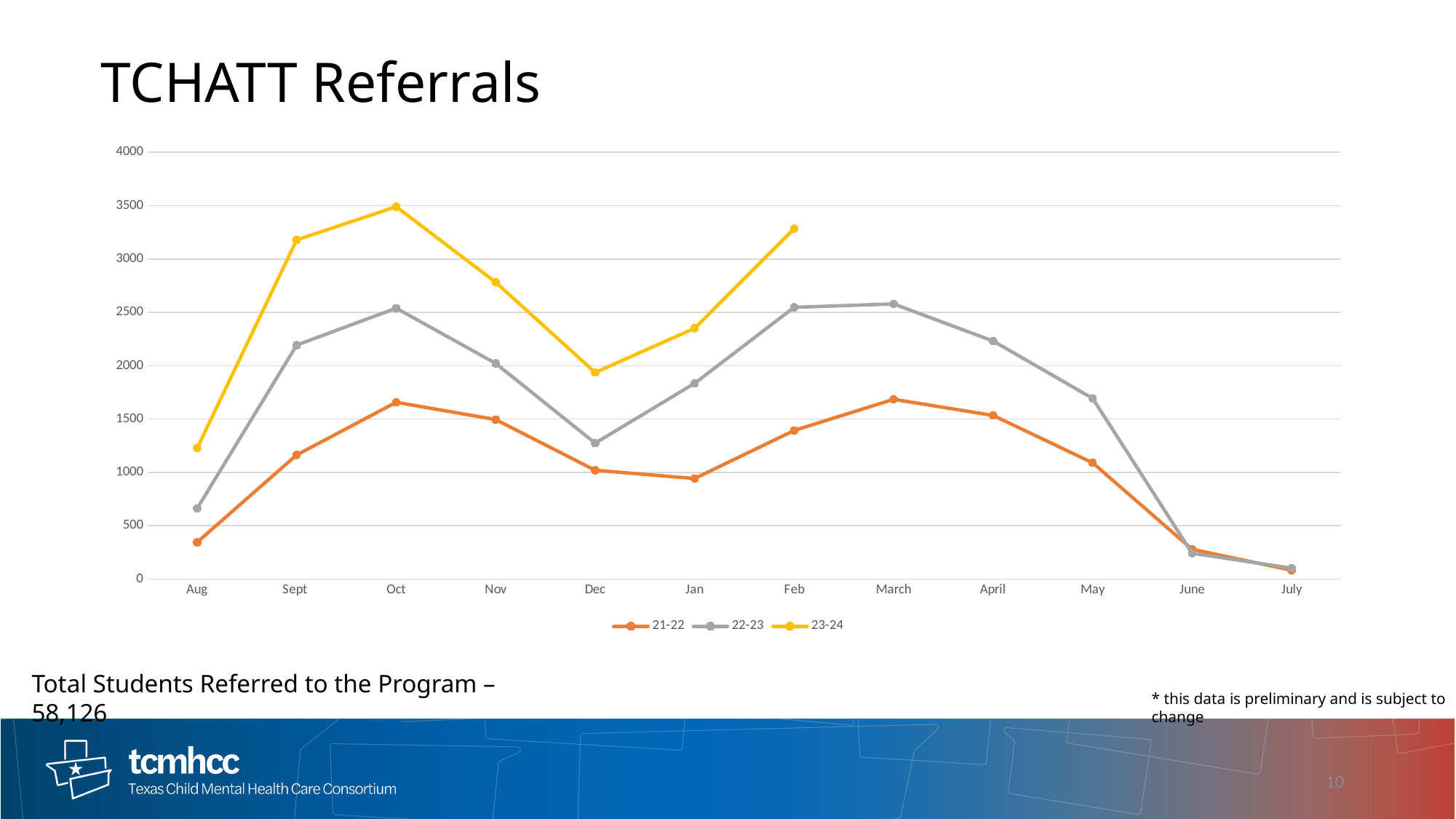
Is the value for 23-24 in Oct greater or less than 3000? greater Is the value for 22-23 in May greater or less than 1500? greater In which month does the 21-22 series reach its lowest value? July Is the value for 22-23 in Aug greater or less than 500? greater What is the title of the slide containing the chart? TCHATT Referrals In which month does the 23-24 series reach its highest value? Oct Which series has the larger value in Oct, 23-24 or 22-23? 23-24 What kind of chart is shown on the slide? line chart How many months are shown along the x axis? 12 Does the 21-22 series rise or fall from March to July? fall How many series does the legend list? 3